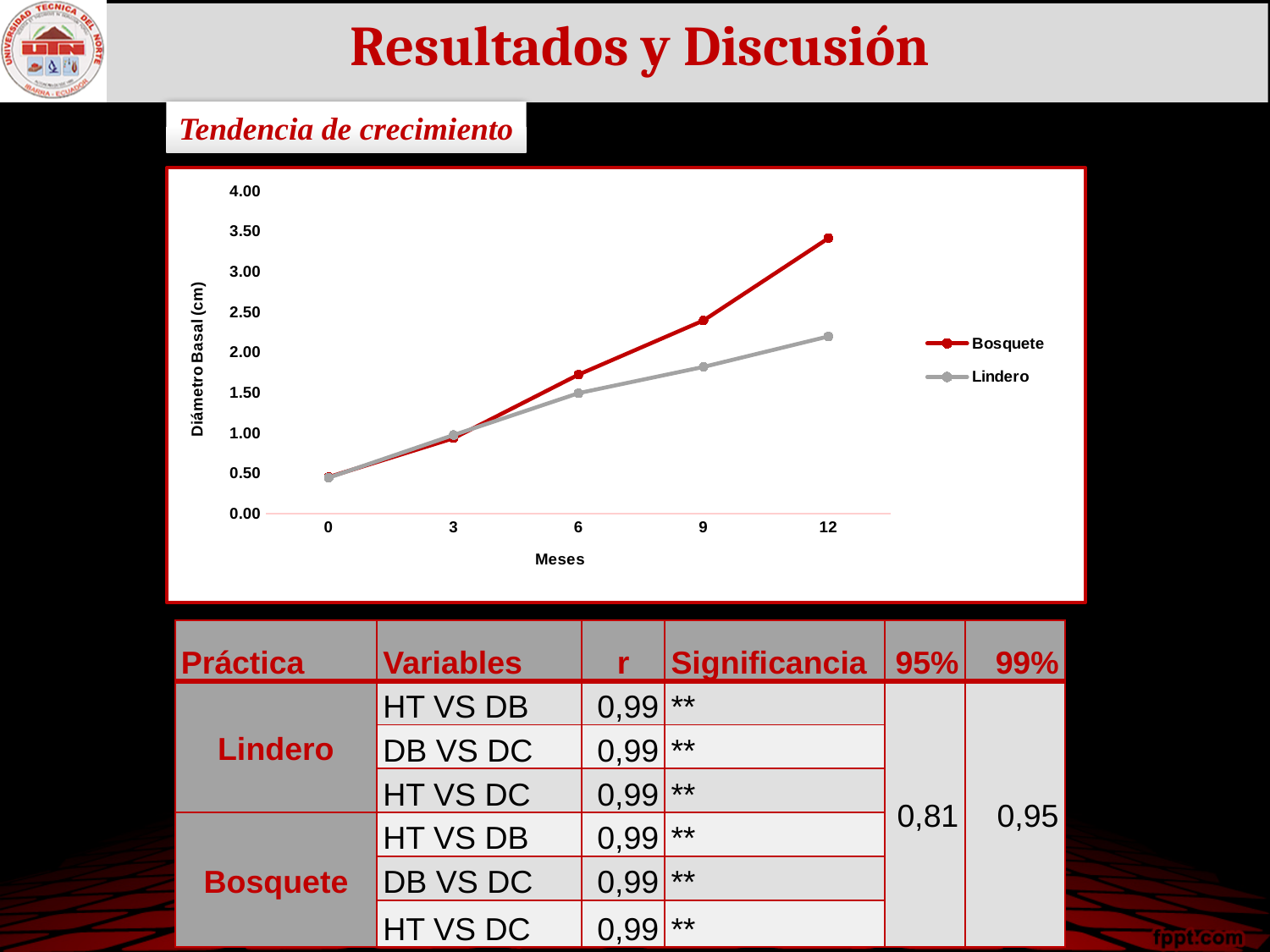
Is the Bosquete value at 12 months greater or less than 3.00? greater How many time points (months) are plotted along the x axis? 5 Is the Lindero value at 9 months greater or less than 2.00? less Is the Lindero value at 12 months greater or less than 2.50? less At 12 months, which series has the larger basal diameter, Bosquete or Lindero? Bosquete At 9 months, which series has the larger basal diameter, Bosquete or Lindero? Bosquete At which month does the Bosquete series reach its highest value? 12 How many series does the chart legend list? 2 What is the label of the chart's y axis? Diámetro Basal (cm) What kind of chart is shown on the slide? line chart Does the Bosquete series rise or fall as the months increase? rise